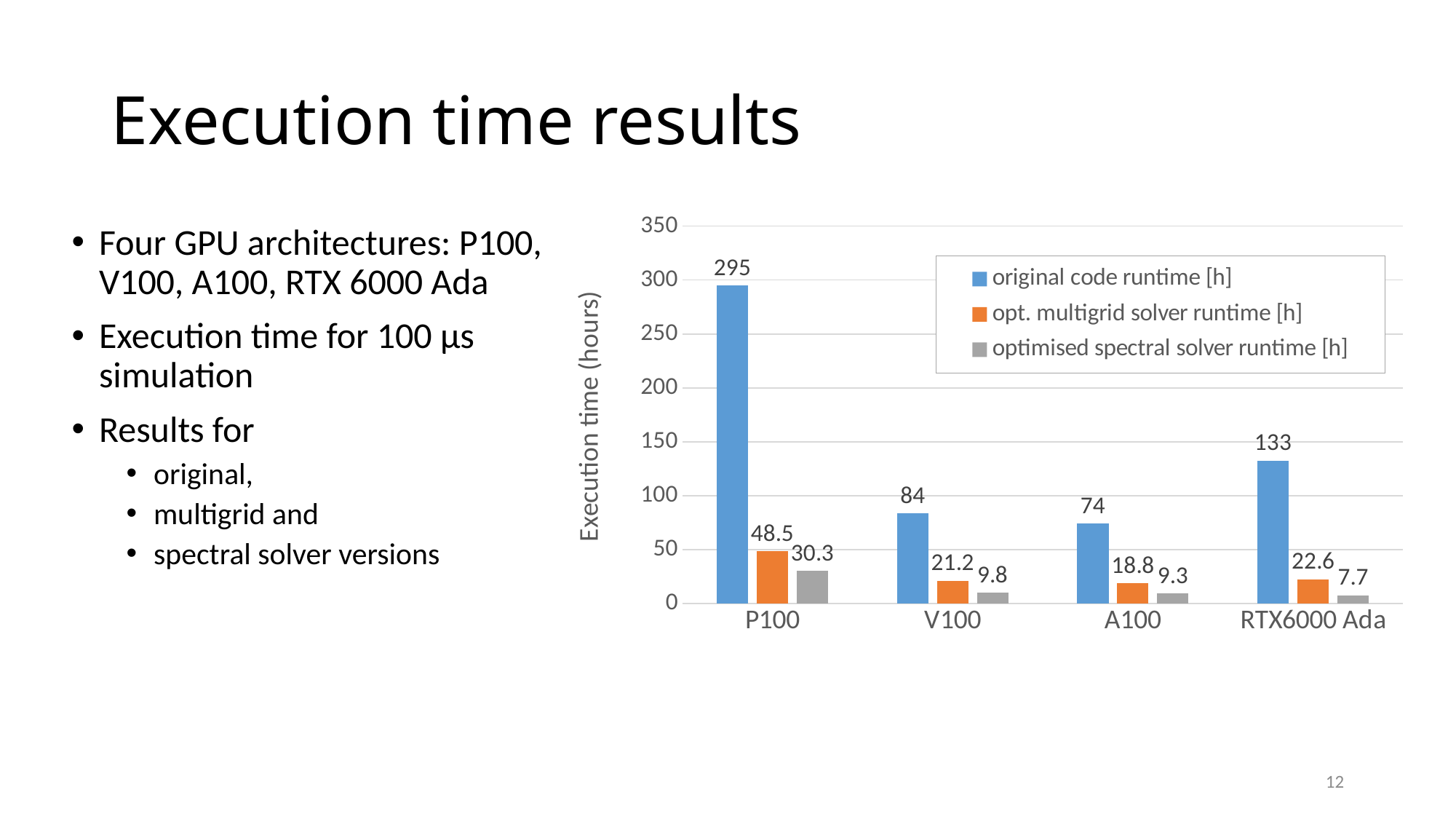
Which GPU has the highest original code runtime? P100 What is the difference between the original code runtime and the opt. multigrid solver runtime for P100? 246.5 What is the label of the vertical axis? Execution time (hours) Which GPU has the lowest optimised spectral solver runtime? RTX6000 Ada Is the original code runtime for A100 greater or less than 100? less How many series does the legend list? 3 How many GPU architectures are shown on the x axis? 4 What is the original code runtime for P100? 295 Which is larger: the original code runtime for V100 or for RTX6000 Ada? RTX6000 Ada What is the opt. multigrid solver runtime for A100? 18.8 What kind of chart is shown on the slide? bar chart What is the optimised spectral solver runtime for V100? 9.8